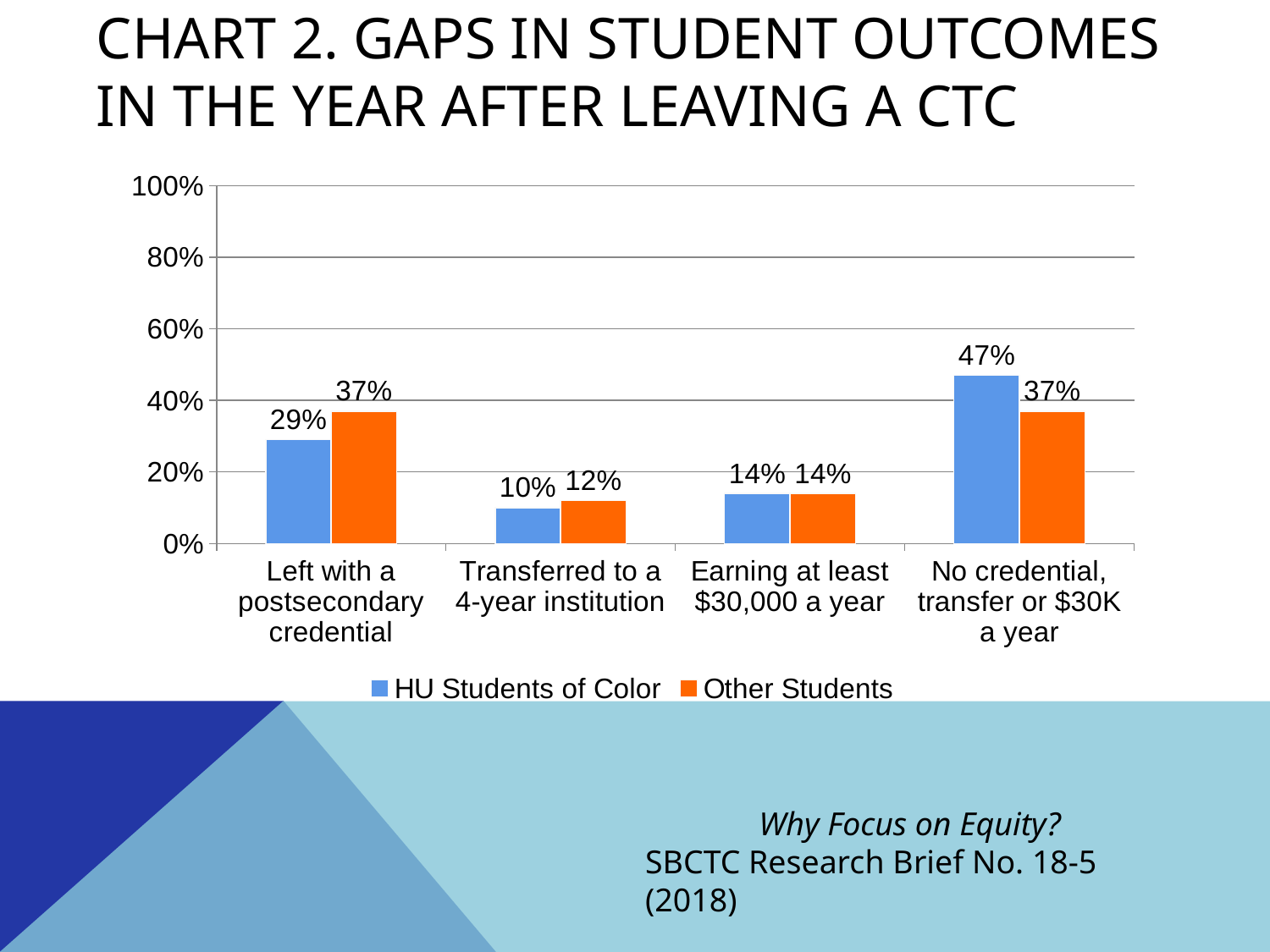
What percentage of HU Students of Color had no credential, transfer or $30K a year? 47% How many series does the legend list? 2 What is the value for Other Students in the 'Transferred to a 4-year institution' category? 12% What is the difference between Other Students and HU Students of Color in the 'Left with a postsecondary credential' category? 8% What percentage of HU Students of Color left with a postsecondary credential? 29% What is the difference between HU Students of Color and Other Students in the 'No credential, transfer or $30K a year' category? 10% Which category has the highest value for HU Students of Color? No credential, transfer or $30K a year What kind of chart is shown on the slide? Bar chart Which category has the lowest value for Other Students? Transferred to a 4-year institution In the 'Transferred to a 4-year institution' category, which series has the larger value? Other Students How many categories are shown on the x axis? 4 Is the value for HU Students of Color in 'No credential, transfer or $30K a year' greater or less than 40%? greater